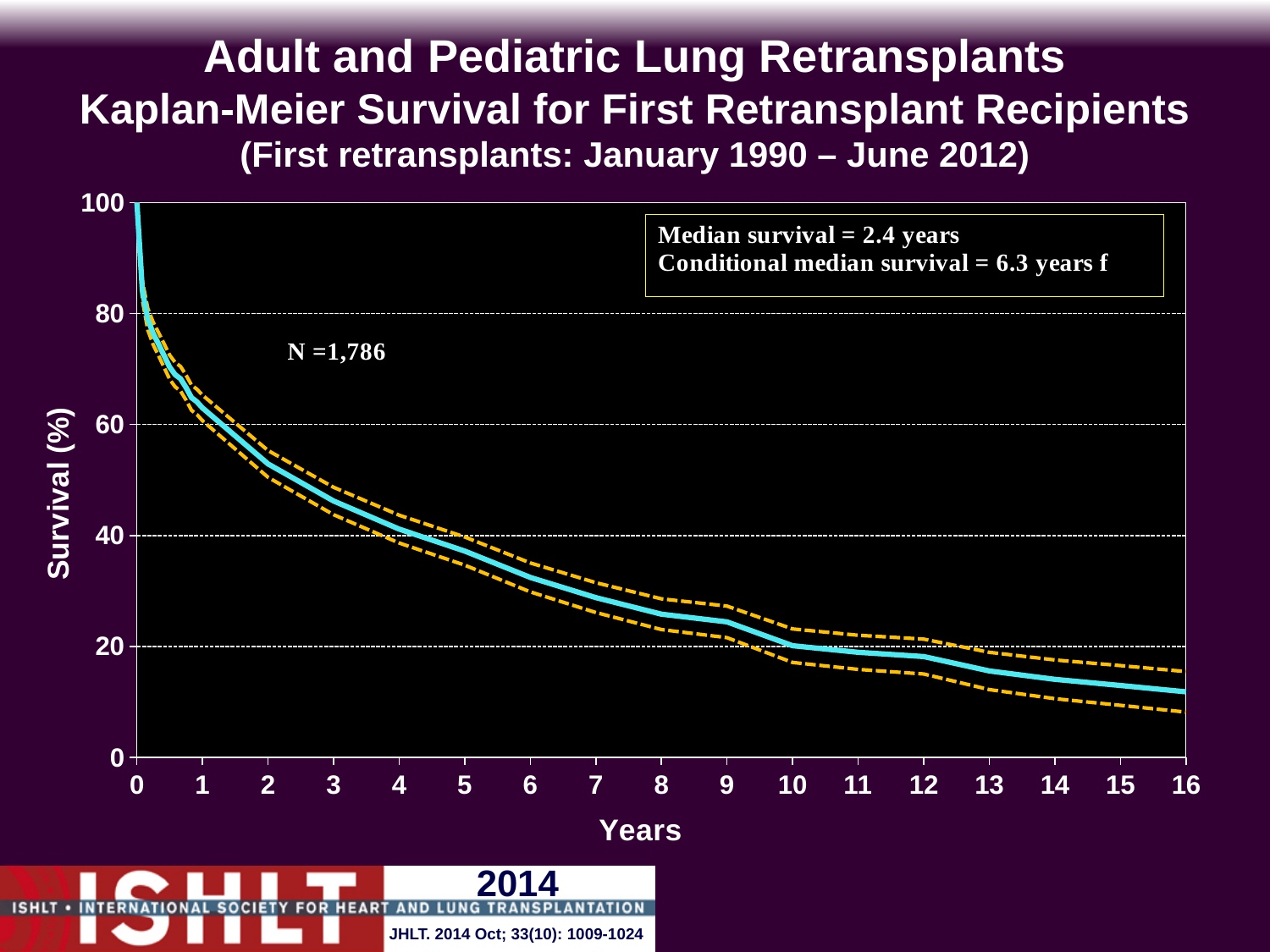
What is the label of the y-axis? Survival (%) What is the median survival stated on the chart? 2.4 years Is the survival value at year 3 greater or less than 40? greater What is the conditional median survival stated on the chart? 6.3 years Is the survival value at year 2 greater or less than 60? less Is the survival value at year 16 greater or less than 20? less What is the survival value at year 0 on the chart? 100 What is the N (number of patients) shown on the chart? 1,786 Does the survival curve rise or fall as years increase? fall What is the highest value shown on the x-axis? 16 What kind of chart is shown on the slide? line chart